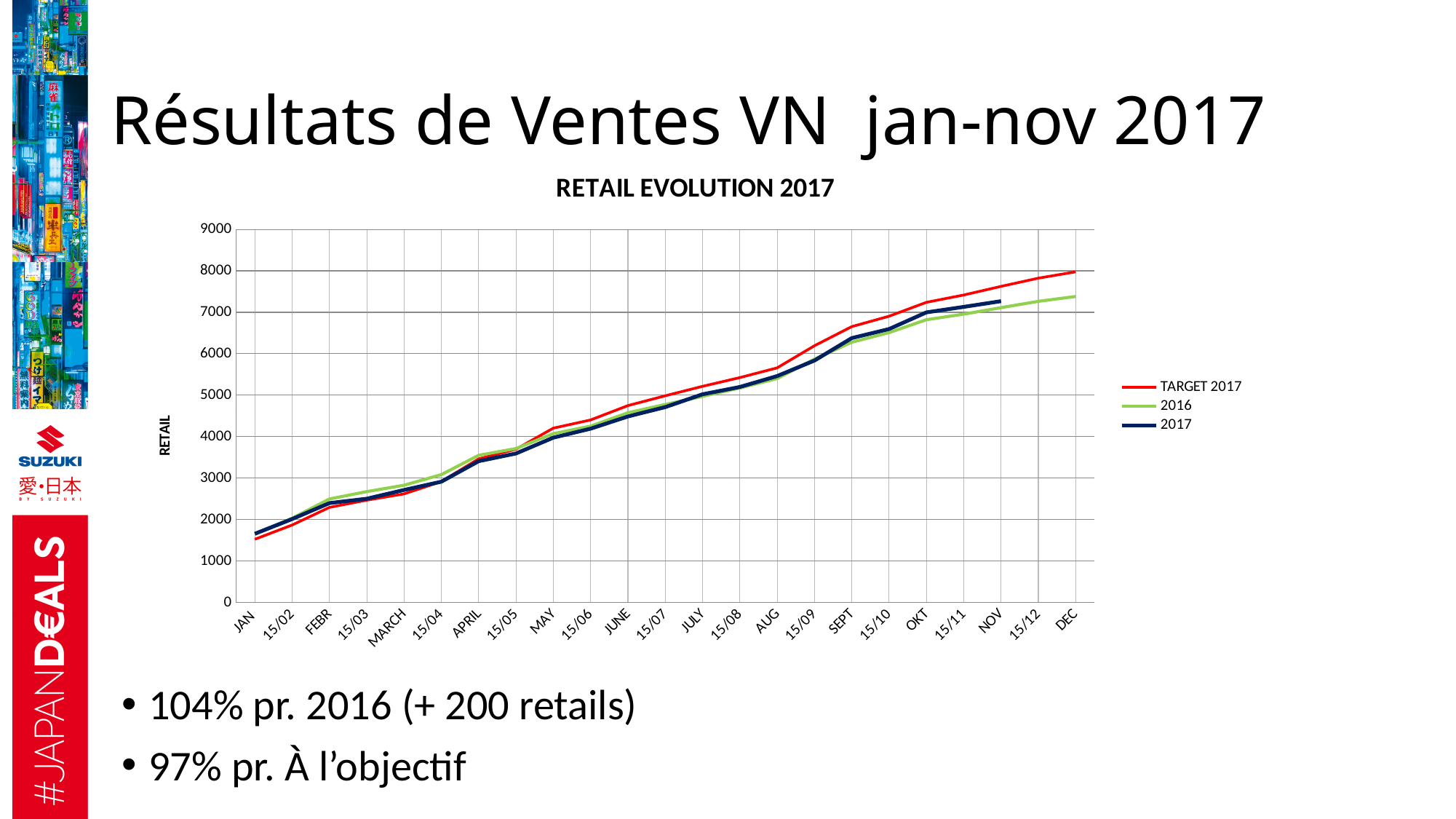
Is the value of the TARGET 2017 series at SEPT greater or less than 6000? greater How many series does the chart's legend list? 3 What kind of chart is shown on the slide? line chart How many categories are shown along the x axis of the chart? 23 Do the values of the 2017 series rise or fall along the x axis? rise Is the value of the TARGET 2017 series at JAN greater or less than 2000? less What is the title of the chart? RETAIL EVOLUTION 2017 At DEC, which series has the higher value: TARGET 2017 or 2016? TARGET 2017 Is the value of the 2017 series at NOV greater or less than 7000? greater At NOV, which series has the higher value: TARGET 2017 or 2017? TARGET 2017 Which series is drawn in red in the chart? TARGET 2017